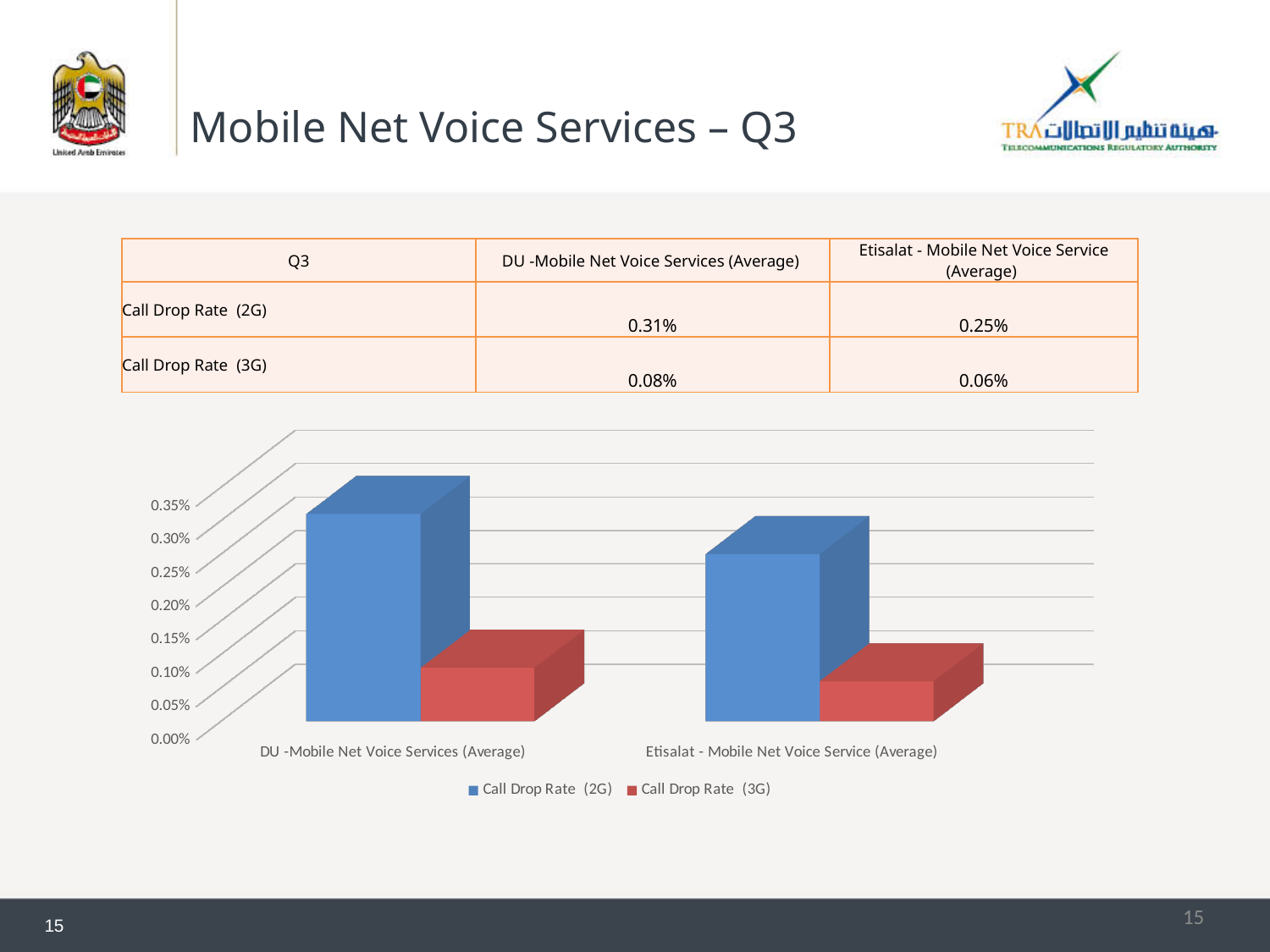
Is the Call Drop Rate (3G) bar for DU greater or less than 0.15%? less What is the Call Drop Rate (2G) for DU - Mobile Net Voice Services (Average)? 0.31% How many series does the chart legend list? 2 Is the Call Drop Rate (2G) bar for Etisalat greater or less than 0.20%? greater Which colour represents Call Drop Rate (3G) in the chart? Red What is the Call Drop Rate (2G) for Etisalat - Mobile Net Voice Service (Average)? 0.25% Which operator has the higher Call Drop Rate (2G)? DU - Mobile Net Voice Services (Average) What is the Call Drop Rate (3G) for Etisalat - Mobile Net Voice Service (Average)? 0.06% What is the difference between the Call Drop Rate (2G) for DU and for Etisalat? 0.06% Which operator has the lower Call Drop Rate (3G)? Etisalat - Mobile Net Voice Service (Average) What type of chart is shown on the slide? Bar chart How many categories are shown on the x axis of the chart? 2